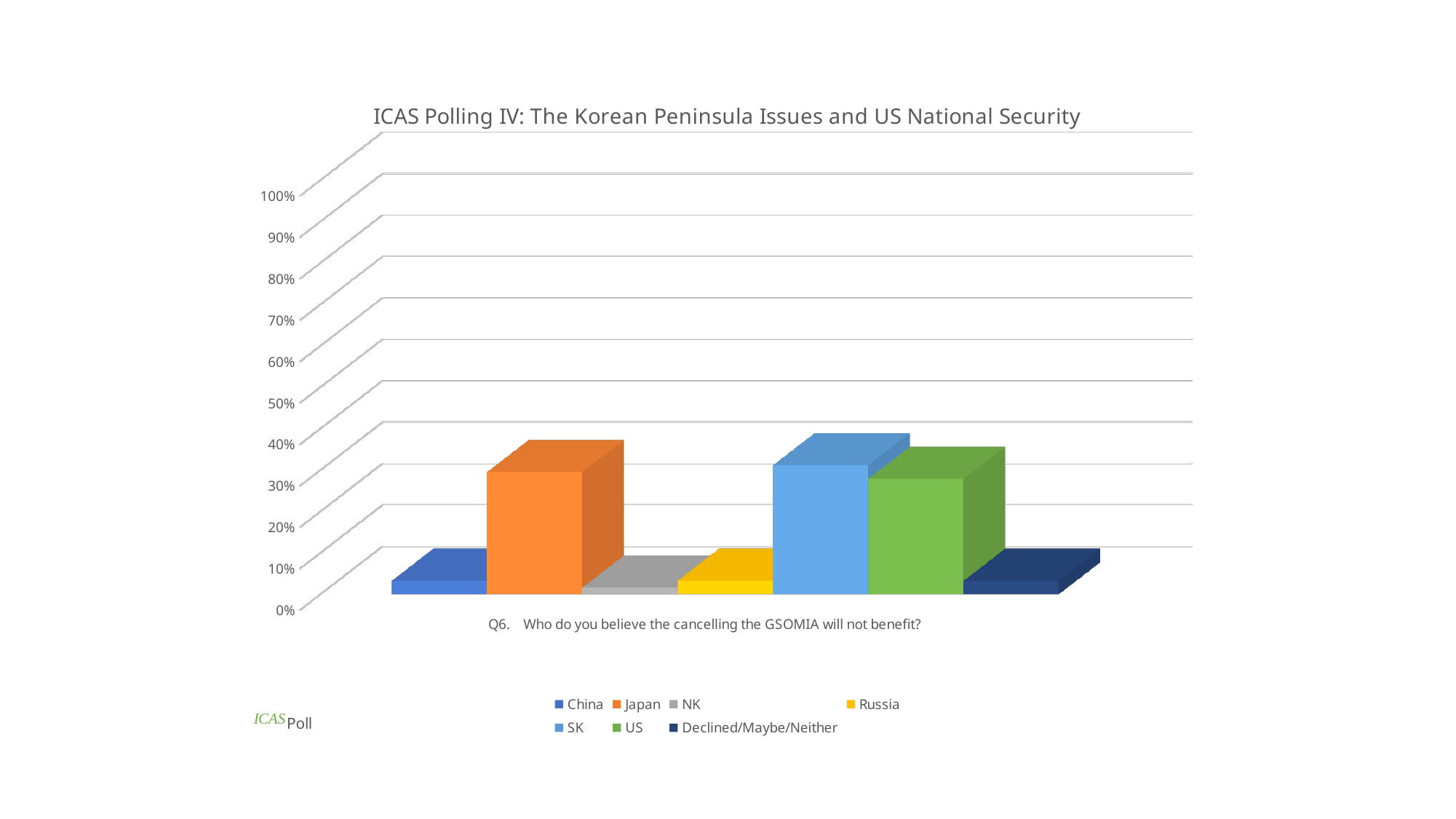
What is the title of the chart? ICAS Polling IV: The Korean Peninsula Issues and US National Security Is the value for Japan greater or less than 20%? greater What kind of chart is shown on the slide? bar chart Which is larger, the value for Russia or the value for NK? Russia Is the value for SK greater or less than 20%? greater How many categories are plotted on the x axis? 1 What question is shown as the category label on the x axis? Q6. Who do you believe the cancelling the GSOMIA will not benefit? Is the value for China greater or less than 10%? less Which is larger, the value for Japan or the value for China? Japan How many series does the legend list? 7 Which series has the lowest value? NK